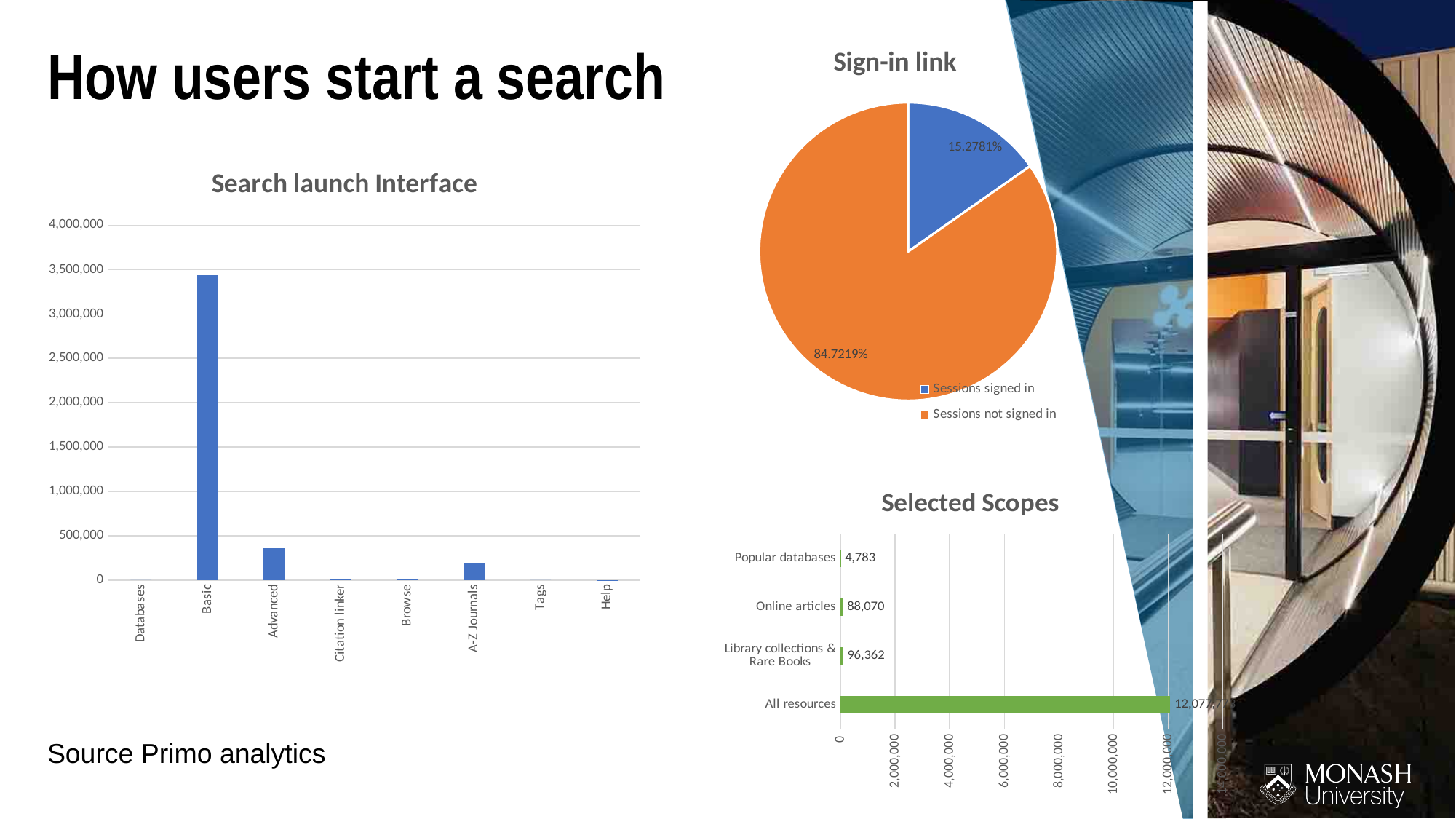
What kind of chart is the Search launch Interface chart? bar chart In the Selected Scopes chart, which category has the lowest value? Popular databases In the Search launch Interface chart, is the value for Basic greater or less than 3,000,000? greater How many entries does the legend of the Sign-in link chart list? 2 In the Search launch Interface chart, which category has the highest value? Basic In the Search launch Interface chart, is the value for Advanced greater or less than 500,000? less In the Search launch Interface chart, which is larger, Advanced or A-Z Journals? Advanced In the Selected Scopes chart, what is the difference between Library collections & Rare Books and Online articles? 8,292 How many categories are shown on the x axis of the Search launch Interface chart? 8 In the Sign-in link chart, what share of sessions were signed in? 15.2781% In the Sign-in link chart, what share of sessions were not signed in? 84.7219% In the Selected Scopes chart, what is the value for Online articles? 88,070